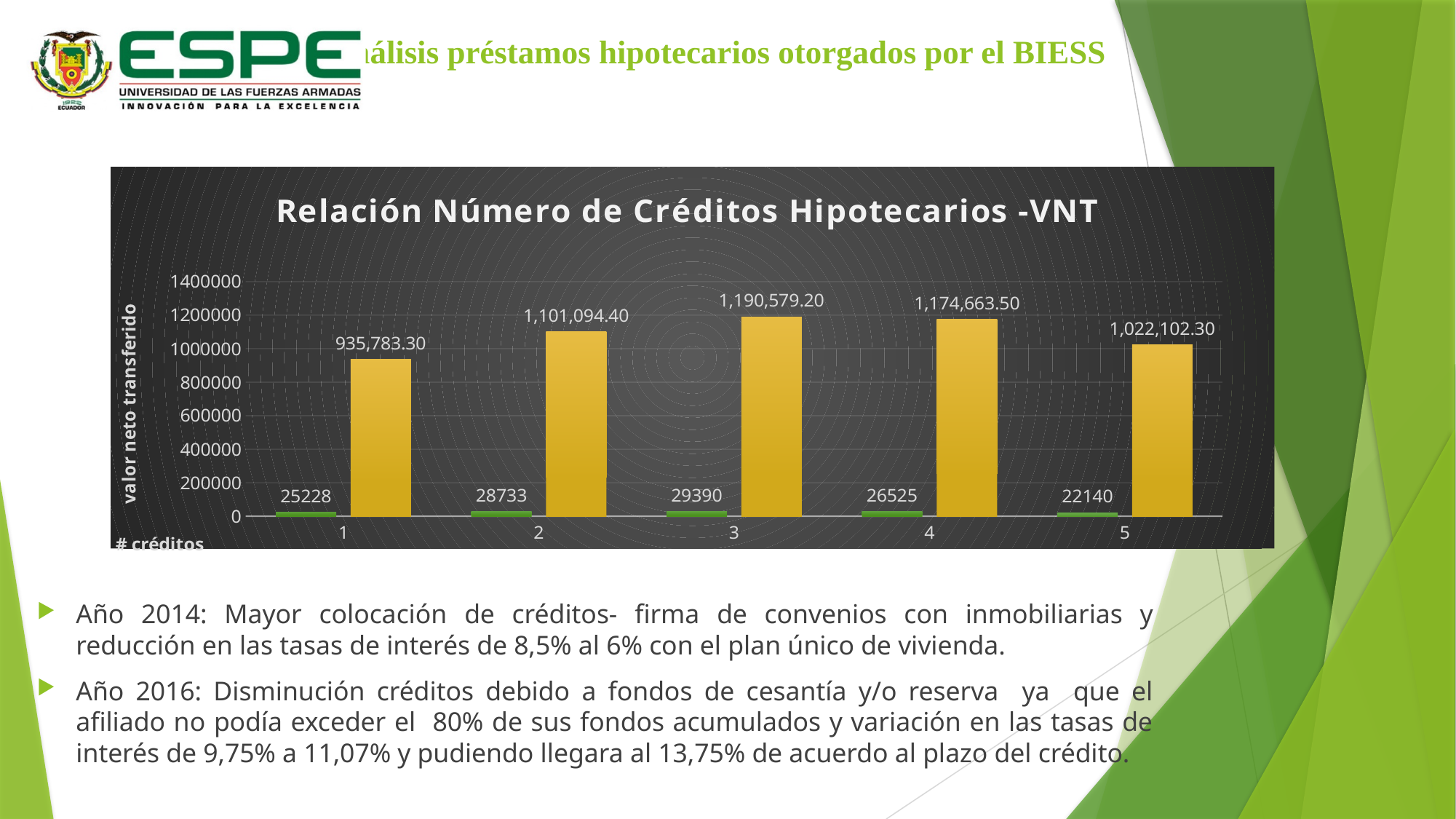
Which category has the lowest number of credits (green bar label)? 5 What is the difference between the gold bar values for category 3 and category 1? 254,795.90 How many categories are shown on the x axis of the chart? 5 What is the number of credits (green bar label) for category 5? 22140 What is the value of the tall gold bar for category 3? 1,190,579.20 Which category has the highest gold bar value? 3 Which is larger, the gold bar value for category 2 or for category 5? category 2 What is the label of the vertical axis of the chart? valor neto transferido What type of chart is shown on the slide? bar chart What is the number of credits (green bar label) for category 2? 28733 What is the title of the chart? Relación Número de Créditos Hipotecarios -VNT What is the value of the gold bar for category 1? 935,783.30